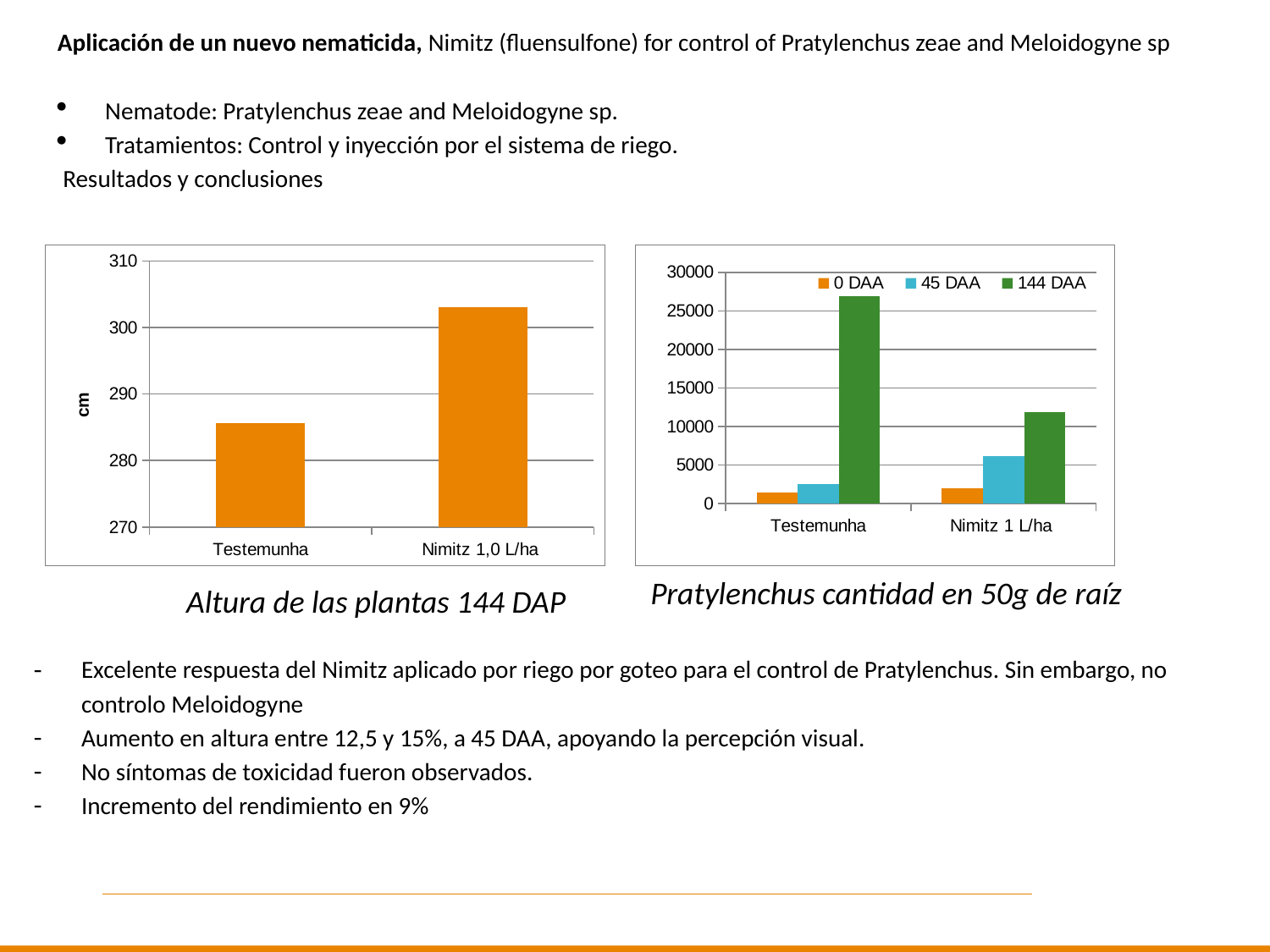
In the chart titled 'Pratylenchus cantidad en 50g de raíz', how many series does the legend list? 3 In the chart titled 'Pratylenchus cantidad en 50g de raíz', is the 144 DAA value for Testemunha greater or less than 25000? greater In the chart titled 'Pratylenchus cantidad en 50g de raíz', which category has the highest 144 DAA value? Testemunha In the chart titled 'Altura de las plantas 144 DAP', which category has the taller bar? Nimitz 1,0 L/ha In the chart titled 'Altura de las plantas 144 DAP', what unit is shown on the y axis label? cm In the chart titled 'Altura de las plantas 144 DAP', what kind of chart is shown? bar chart In the chart titled 'Altura de las plantas 144 DAP', is the value for Testemunha greater or less than 290? less In the chart titled 'Altura de las plantas 144 DAP', how many categories are shown on the x axis? 2 In the chart titled 'Pratylenchus cantidad en 50g de raíz', what are the legend entries? 0 DAA, 45 DAA, 144 DAA In the chart titled 'Pratylenchus cantidad en 50g de raíz', is the 144 DAA value for Nimitz 1 L/ha greater or less than 15000? less In the chart titled 'Pratylenchus cantidad en 50g de raíz', which is larger: the 45 DAA value for Testemunha or the 45 DAA value for Nimitz 1 L/ha? Nimitz 1 L/ha